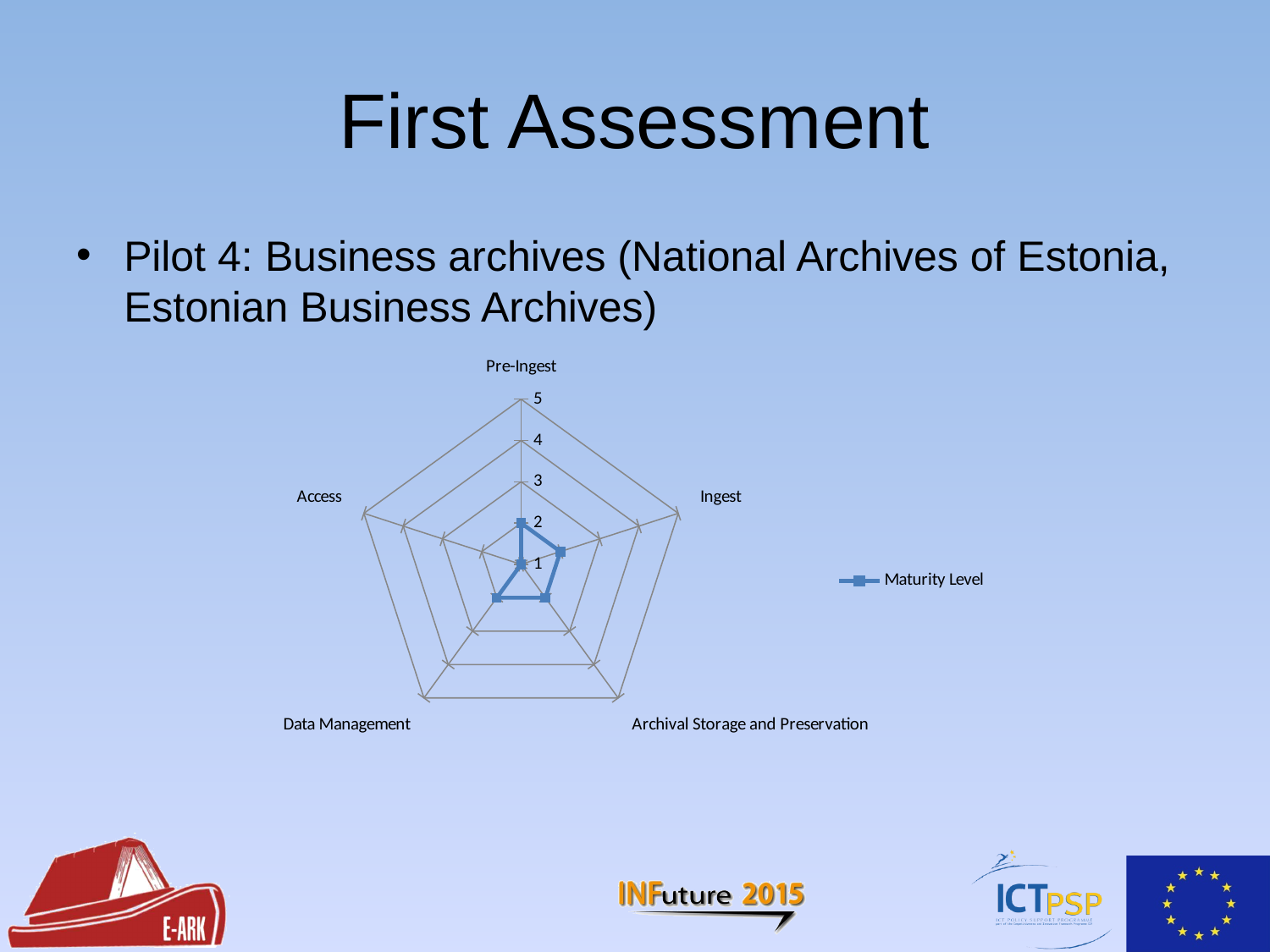
What is the Maturity Level value for Ingest? 2 Which is larger, the Maturity Level for Pre-Ingest or for Access? Pre-Ingest What is the Maturity Level value for Pre-Ingest? 2 What is the name of the series shown in the legend of the radar chart? Maturity Level What is the Maturity Level value for Access? 1 What is the highest value shown on the radar chart's axis scale? 5 What type of chart is shown on the slide? Radar chart What is the difference between the Maturity Level for Pre-Ingest and for Access? 1 Is the Maturity Level for Archival Storage and Preservation greater or less than 3? less Which category has the lowest Maturity Level? Access How many series does the legend of the radar chart list? 1 How many categories (axes) does the radar chart have? 5